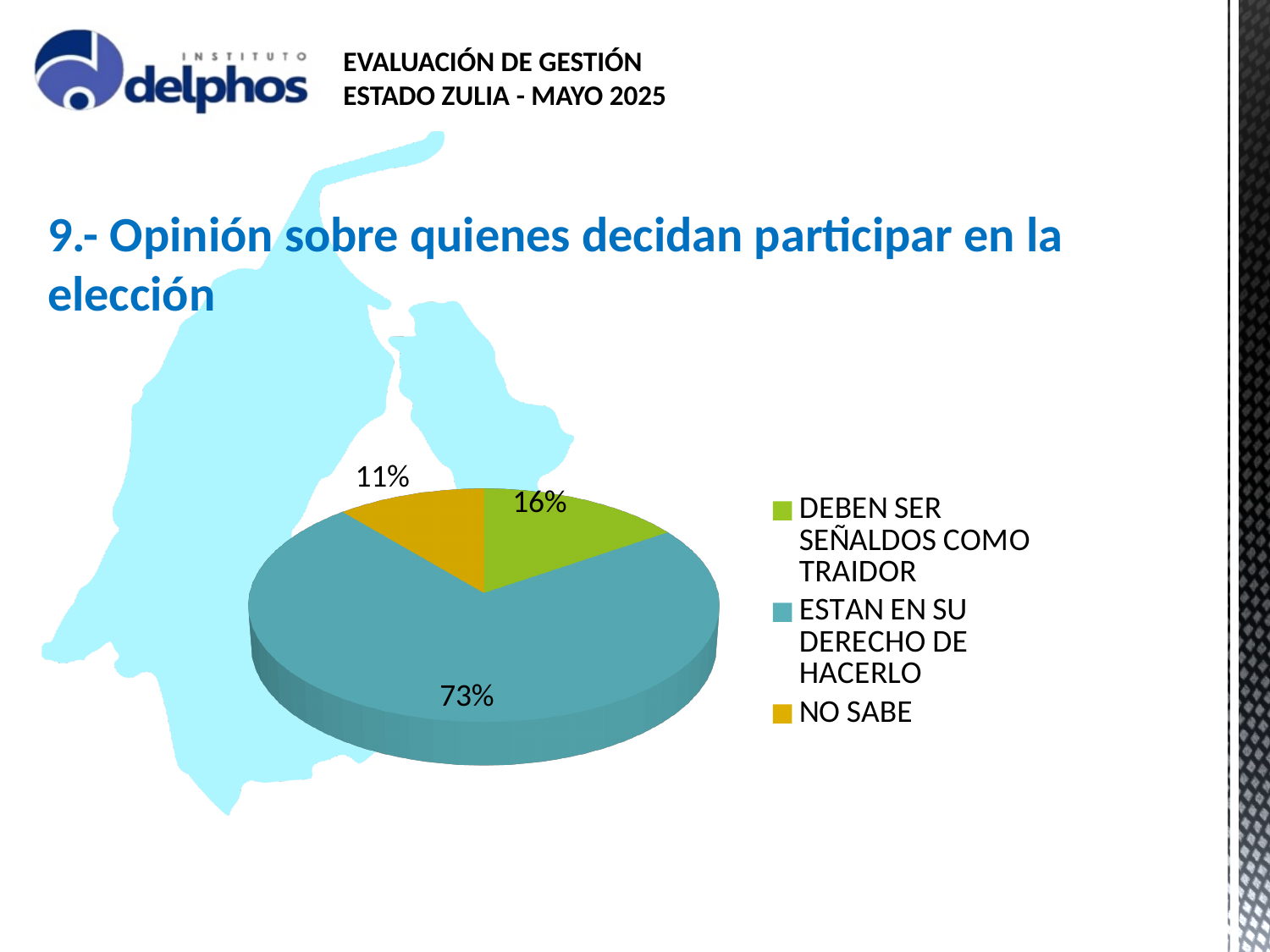
What kind of chart is shown on the slide? Pie chart What colour is the slice for "NO SABE"? Yellow What percentage of respondents answered "ESTAN EN SU DERECHO DE HACERLO"? 73% How many categories does the pie chart have? 3 What is the difference in percentage points between "DEBEN SER SEÑALDOS COMO TRAIDOR" and "NO SABE"? 5 percentage points What percentage of respondents answered "DEBEN SER SEÑALDOS COMO TRAIDOR"? 16% Which category has the largest share of the pie? ESTAN EN SU DERECHO DE HACERLO What is the difference in percentage points between "ESTAN EN SU DERECHO DE HACERLO" and "DEBEN SER SEÑALDOS COMO TRAIDOR"? 57 percentage points Which category has the smallest share of the pie? NO SABE What is the title of the question shown above the chart? 9.- Opinión sobre quienes decidan participar en la elección What percentage of respondents answered "NO SABE"? 11% Which is larger: the share for "DEBEN SER SEÑALDOS COMO TRAIDOR" or the share for "NO SABE"? DEBEN SER SEÑALDOS COMO TRAIDOR